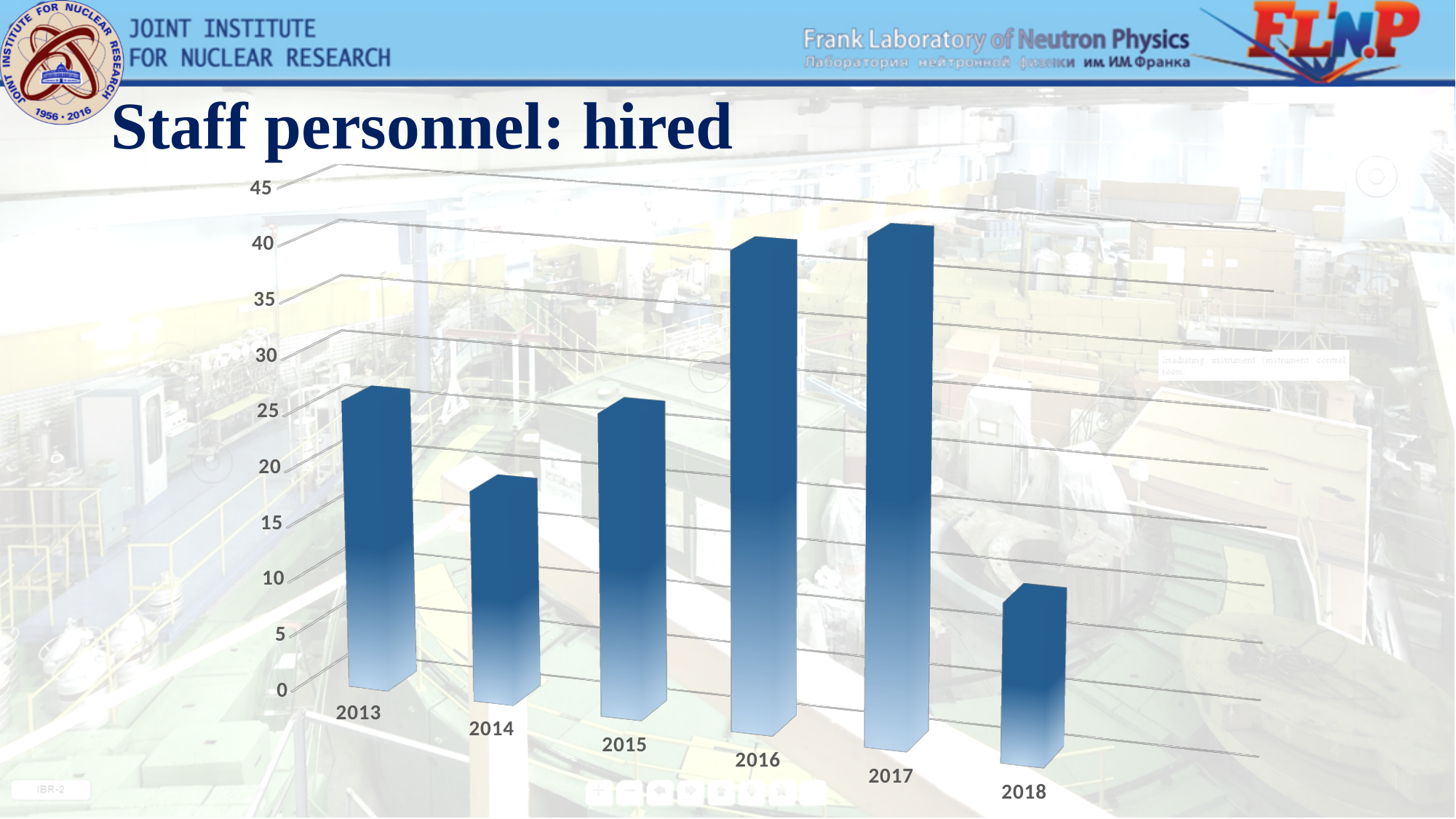
Which year has the lowest number of hired staff? 2018 Is the value for 2013 greater or less than 20? greater Is the value for 2017 greater or less than 35? greater Which year has the larger value, 2013 or 2014? 2013 What is the title of the slide containing the chart? Staff personnel: hired Which year has the larger value, 2015 or 2018? 2015 Is the value for 2016 greater or less than 35? greater What kind of chart is shown on the slide? bar chart Which year has the larger value, 2016 or 2014? 2016 How many years are shown on the x axis of the chart? 6